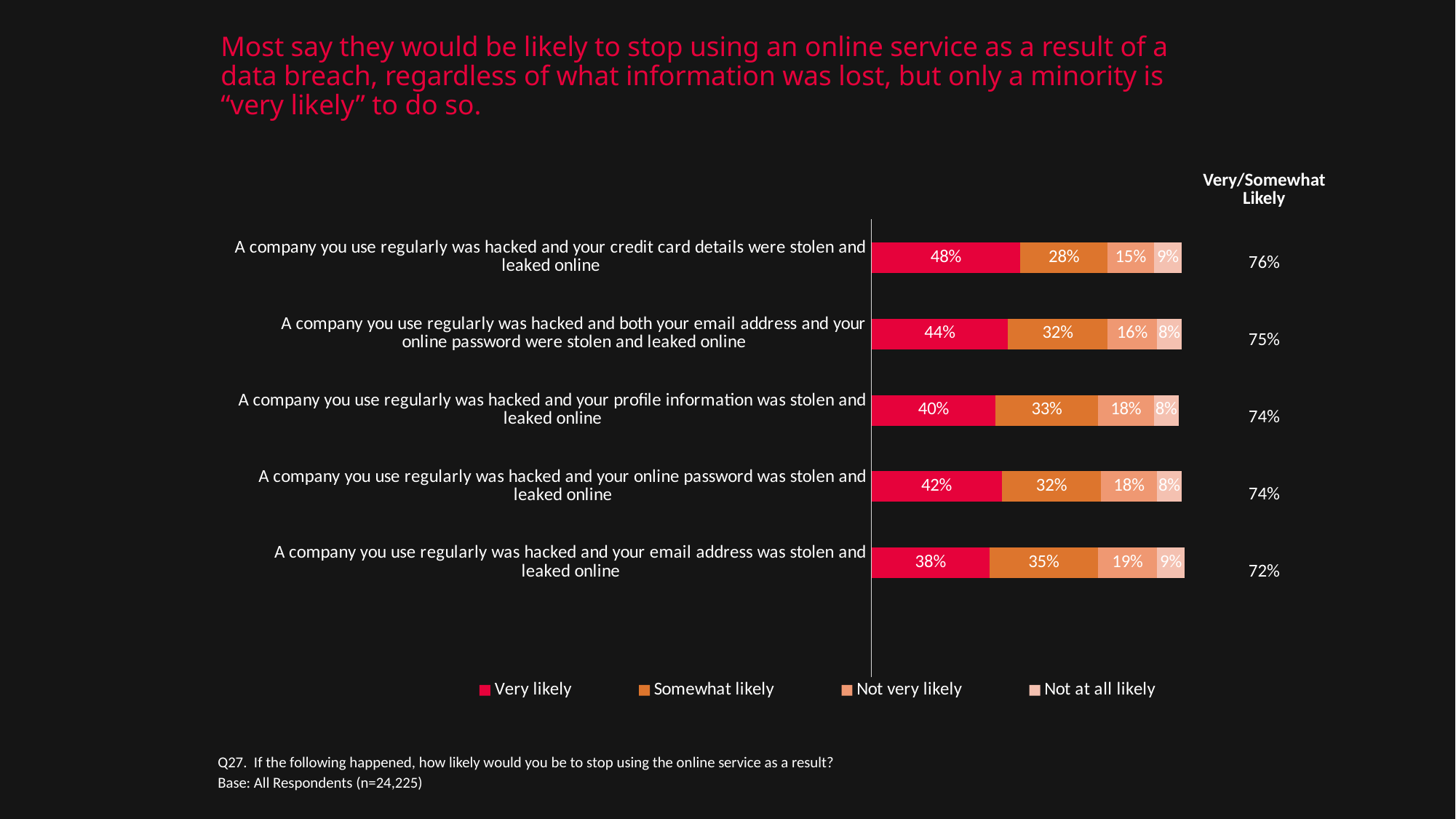
What is the "Not very likely" value for the scenario where the profile information was stolen and leaked online? 18% What is the "Somewhat likely" value for the scenario where the email address was stolen and leaked online? 35% What is the difference between the "Very likely" values for the credit card details scenario and the email address scenario? 10% How many series does the legend list? 4 Which is larger: the "Very likely" value for the online password scenario or for the profile information scenario? Online password (42%) What kind of chart is shown on the slide? Stacked bar chart Which scenario has the lowest "Very likely" share? A company you use regularly was hacked and your email address was stolen and leaked online Which scenario has the highest "Very likely" share? A company you use regularly was hacked and your credit card details were stolen and leaked online What is the combined Very/Somewhat Likely value for the scenario where both the email address and online password were stolen? 75% What percentage of respondents are "Very likely" to stop using a service if their credit card details were stolen and leaked online? 48% Which legend entry is shown in red? Very likely How many scenarios (categories) are shown in the chart? 5